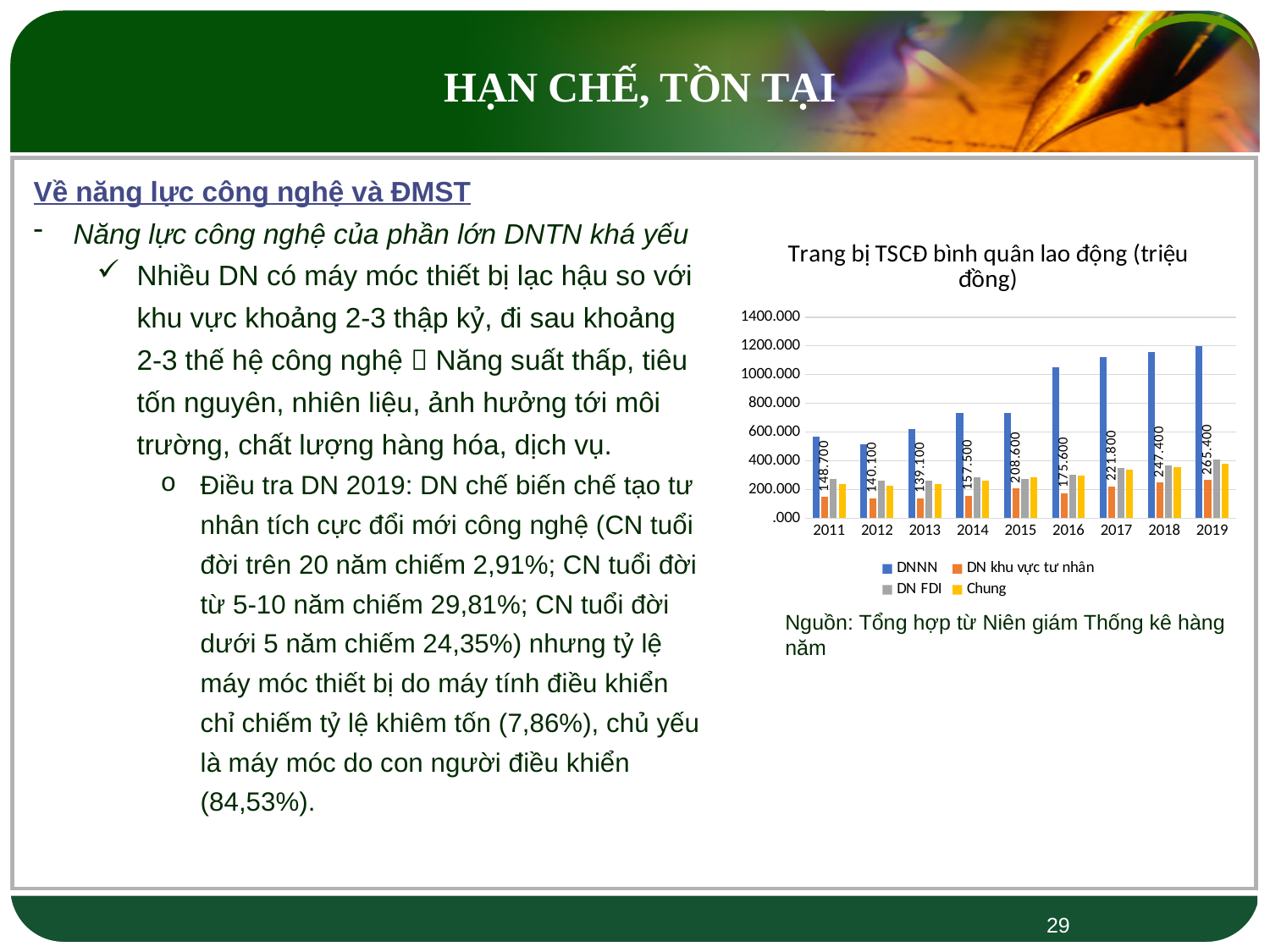
Is the value for DNNN in 2011 greater or less than 800.000? less Which year has the larger value for DN khu vực tư nhân, 2015 or 2016? 2015 What is the value for DN khu vực tư nhân in 2011? 148.700 In which year is the value for DN khu vực tư nhân lowest? 2013 What is the difference between the DN khu vực tư nhân values for 2019 and 2011? 116.700 How many series does the chart's legend list? 4 What is the value for DN khu vực tư nhân in 2019? 265.400 Is the value for DNNN in 2018 greater or less than 1000.000? greater In which year is the value for DN khu vực tư nhân highest? 2019 What kind of chart is shown on the slide? bar chart How many years are shown on the x axis of the chart? 9 What is the value for DN khu vực tư nhân in 2015? 208.600